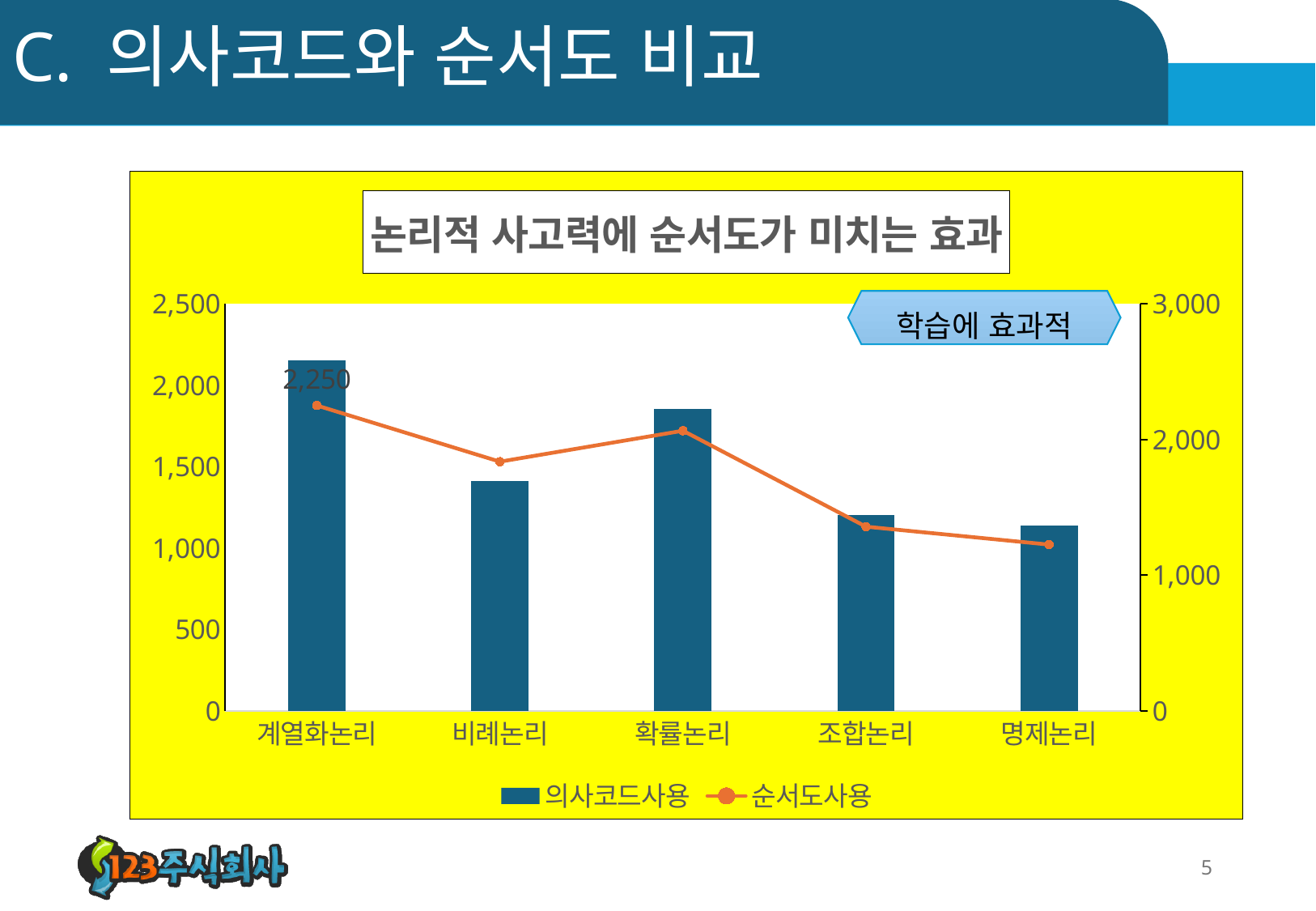
Is the 의사코드사용 value for 계열화논리 greater or less than 2,000? greater How many categories are shown on the x axis? 5 What is the value of the 순서도사용 series for 계열화논리? 2,250 Which category has the highest 의사코드사용 bar? 계열화논리 Which category has the highest 순서도사용 value? 계열화논리 How many series does the legend list? 2 Is the 의사코드사용 value for 비례논리 greater or less than 1,500? less Does the 순서도사용 line generally rise or fall from 계열화논리 to 명제논리? fall Which has the larger 의사코드사용 bar, 비례논리 or 조합논리? 비례논리 What kind of chart is shown on the slide? A combined bar and line chart Which category has the lowest 순서도사용 value? 명제논리 What is the title of the chart? 논리적 사고력에 순서도가 미치는 효과